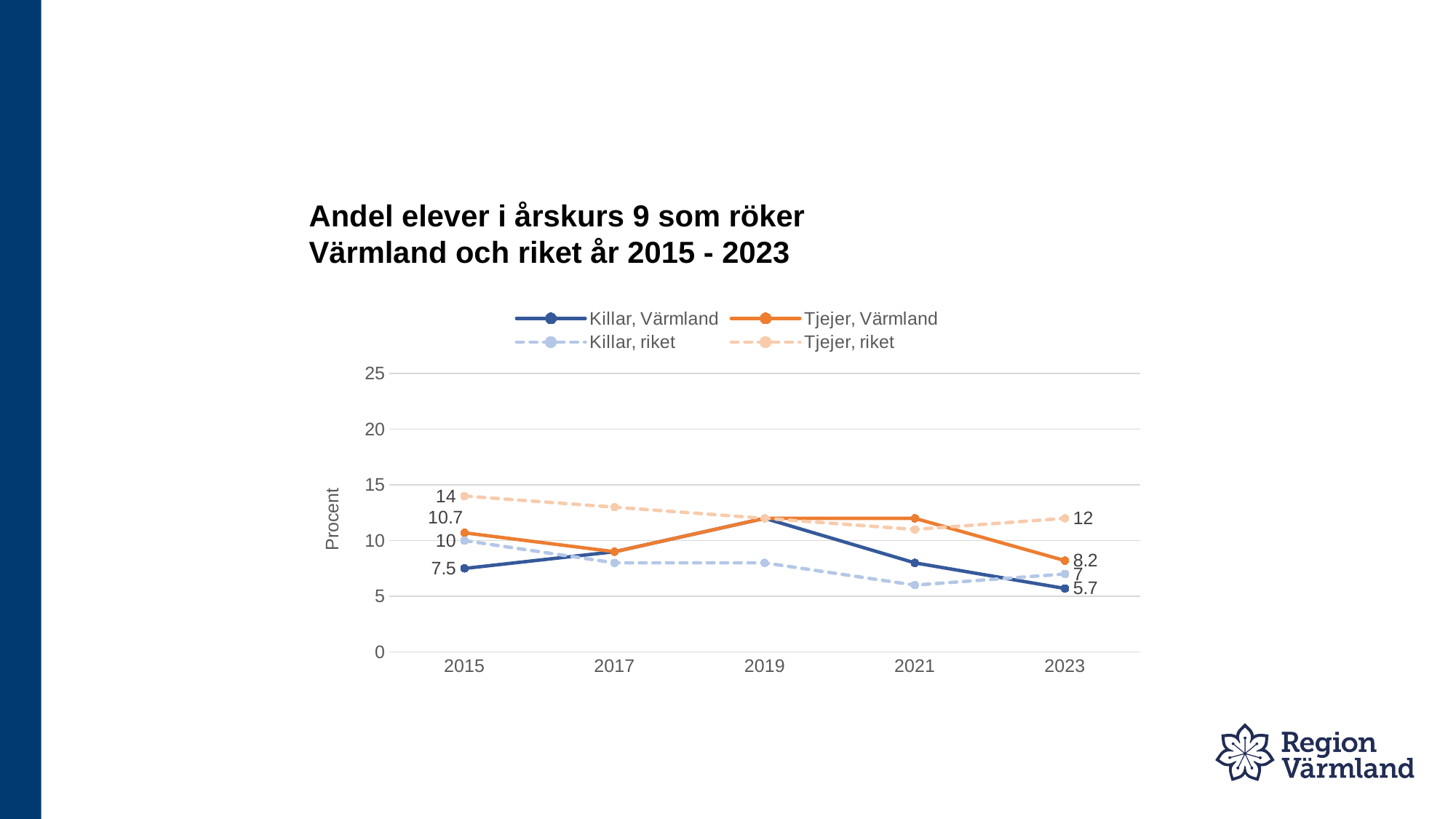
How many series does the legend list? 4 How many years are shown on the x axis? 5 Does the value for Killar, Värmland rise or fall from 2015 to 2023? fall Is the value for Tjejer, Värmland in 2019 greater or less than 10? greater What is the value for Tjejer, riket in 2023? 12 What kind of chart is shown on the slide? line chart Which series has the highest value in 2015? Tjejer, riket What is the difference between Tjejer, Värmland and Killar, Värmland in 2023? 2.5 What is the value for Tjejer, Värmland in 2023? 8.2 What is the value for Killar, Värmland in 2015? 7.5 What is the value for Killar, riket in 2015? 10 Which series has the lowest value in 2023? Killar, Värmland